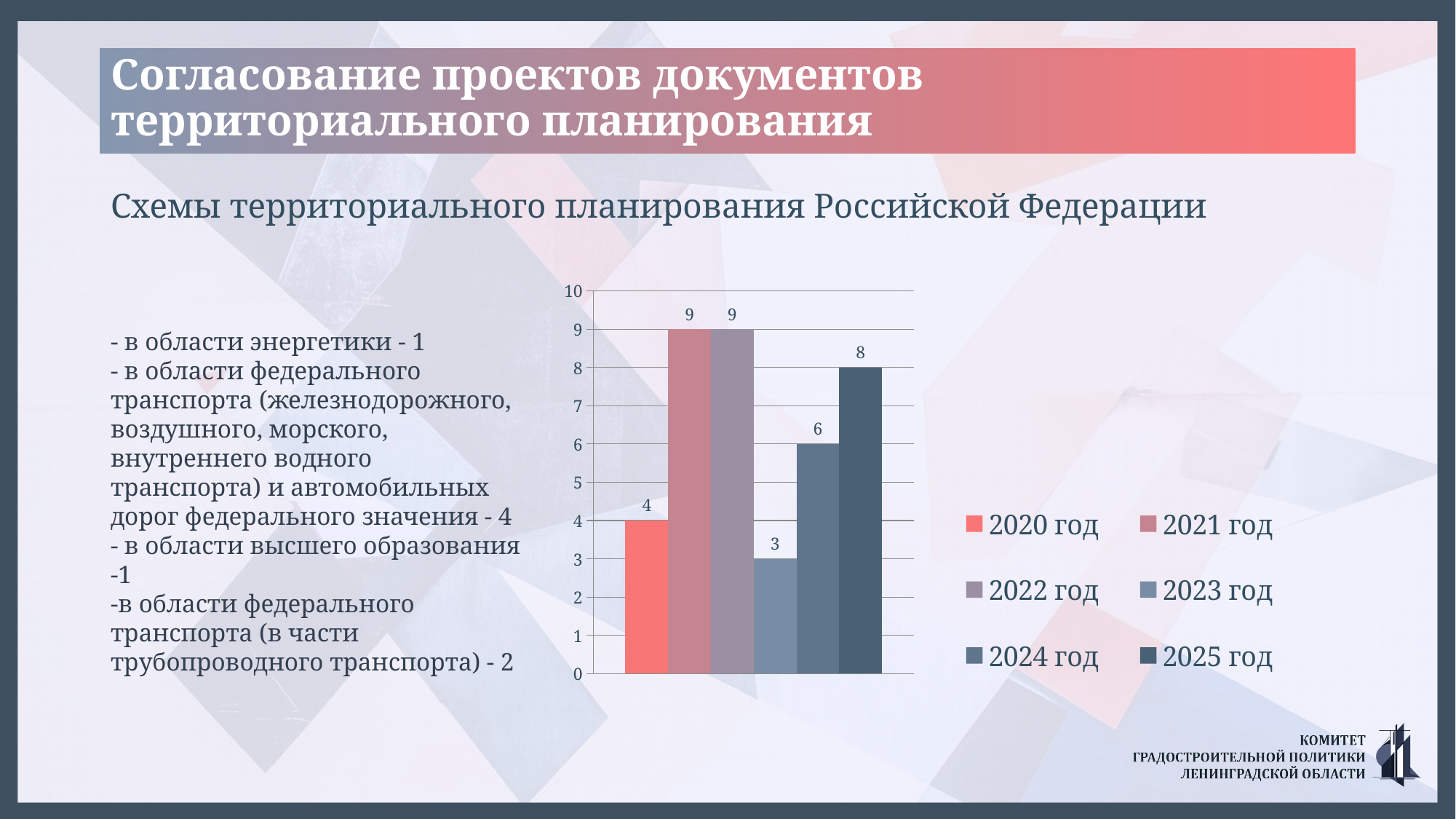
What is the value for 2024 год? 6 What is the value for 2020 год? 4 What kind of chart is shown on the slide? bar chart What colour is the bar for 2020 год? red What is the highest value shown on the vertical axis? 10 What is the difference between the values for 2021 год and 2020 год? 5 How many series does the legend list? 6 Which is larger, the value for 2024 год or the value for 2020 год? 2024 год What is the difference between the values for 2025 год and 2023 год? 5 What is the value for 2023 год? 3 Which year has the lowest value? 2023 год What is the value for 2025 год? 8